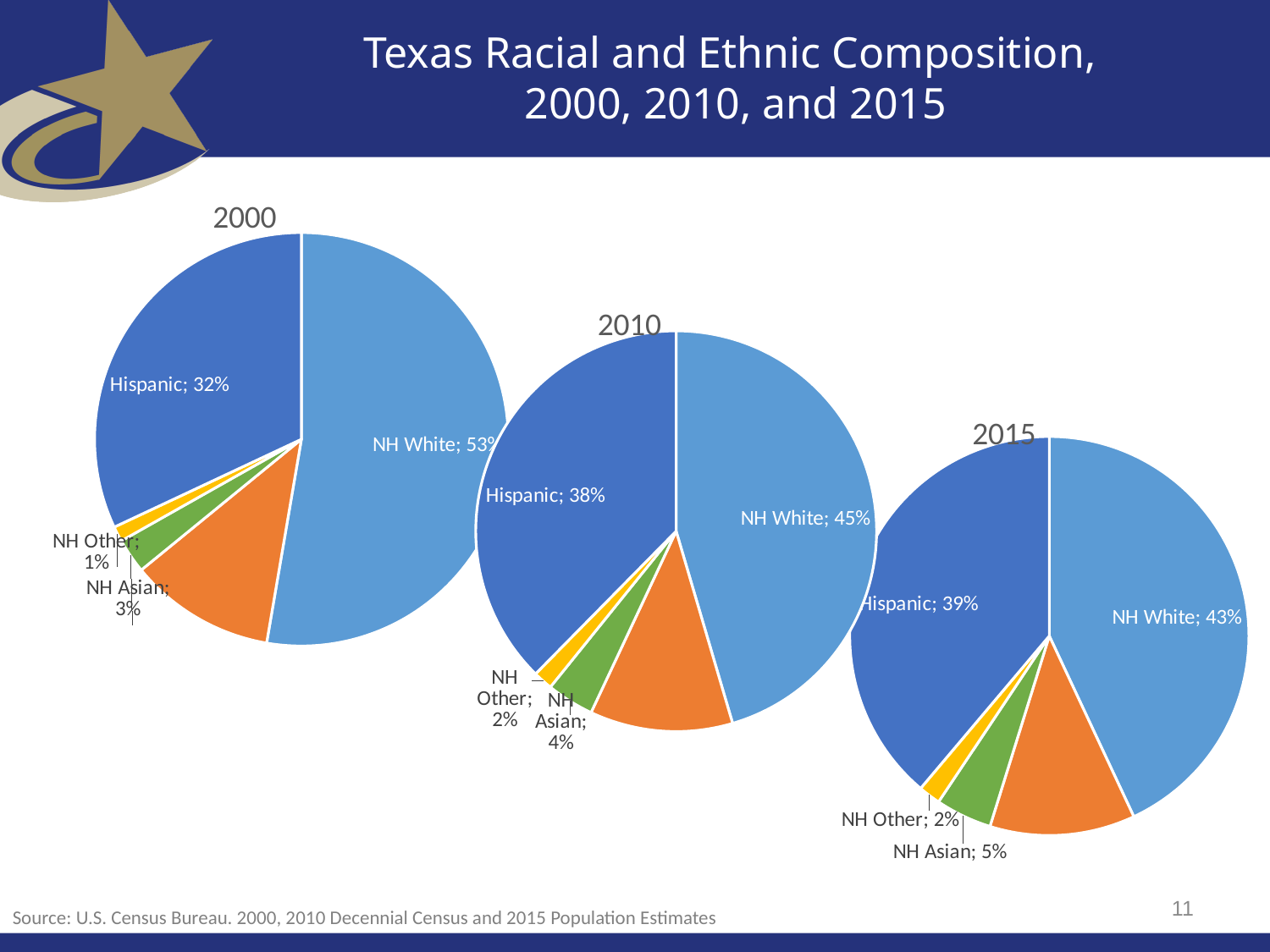
How many slices does the 2015 pie chart have? 5 In the 2010 pie chart, which labeled group has the largest share? NH White In the 2015 pie chart, what share is Hispanic? 39% Across the 2000, 2010, and 2015 pie charts, does the NH White share rise or fall? Fall In the 2010 pie chart, which is larger, the Hispanic share or the NH White share? NH White What type of chart is used to show the 2000 composition? Pie chart In the 2015 pie chart, what is the difference between the NH White and Hispanic shares? 4% In the 2000 pie chart, which labeled group has the smallest share? NH Other In the 2015 pie chart, what share is NH Other? 2% In the 2010 pie chart, what share is NH Asian? 4% In the 2000 pie chart, what share is Hispanic? 32% In the 2000 pie chart, what share is NH White? 53%